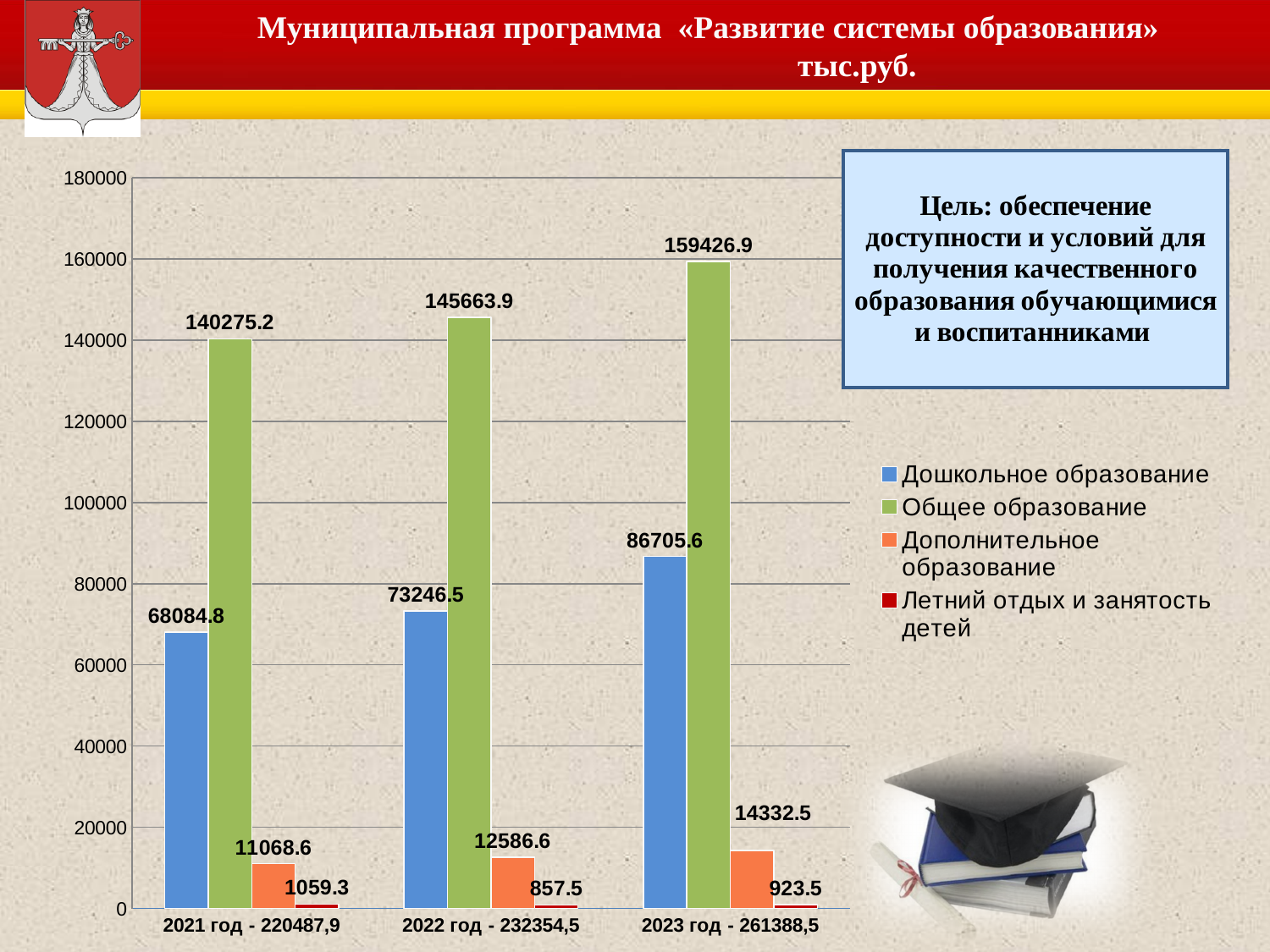
What is the value for Дошкольное образование in 2023 год? 86705.6 How many series does the legend list? 4 What is the difference between the Общее образование values for 2023 год and 2021 год? 19151.7 Do the values for Дошкольное образование rise or fall from 2021 год to 2023 год? rise What is the value for Общее образование in 2021 год? 140275.2 What is the value for Летний отдых и занятость детей in 2021 год? 1059.3 In which year is the value for Общее образование the highest? 2023 год In which year is the value for Летний отдых и занятость детей the lowest? 2022 год How many year categories are shown on the x axis? 3 What type of chart is shown on the slide? bar chart Which is larger: Дошкольное образование in 2022 год or Дошкольное образование in 2023 год? 2023 год What is the value for Дополнительное образование in 2022 год? 12586.6